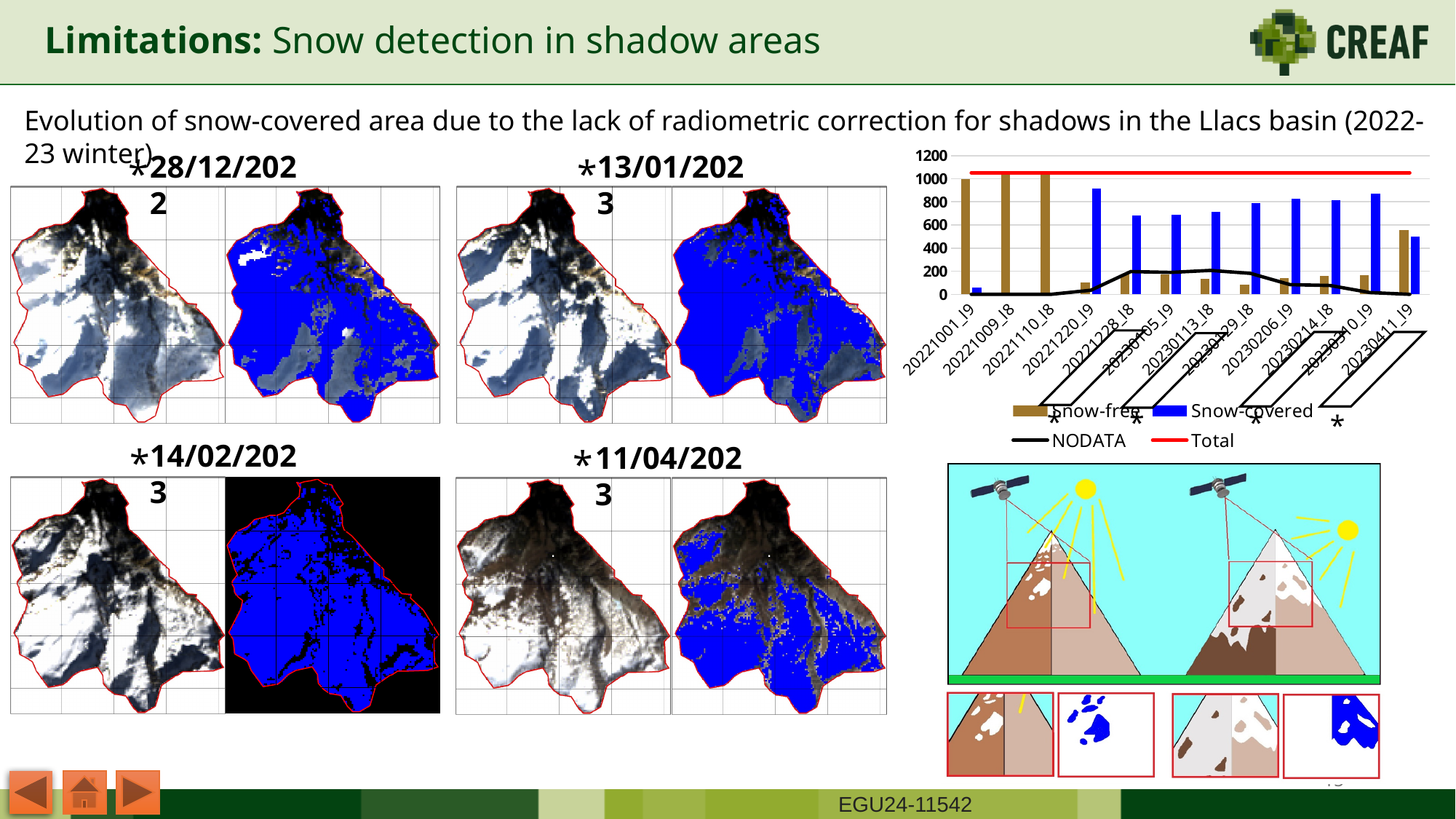
Is the Snow-covered value for 20230411_l9 greater or less than 600? less For 20221001_l9, which is larger: the Snow-free value or the Snow-covered value? Snow-free Which date has the lowest Snow-covered value in the chart? 20221009_l8 How many series does the legend of the chart list? 4 What kind of chart is shown on the right of the slide? combination bar and line chart Which series in the chart is drawn as a red line? Total Which series in the chart is drawn in blue? Snow-covered Is the Snow-covered value for 20221001_l9 greater or less than 200? less How many dates (categories) are shown on the x axis of the chart? 12 Is the Snow-covered value for 20221220_l9 greater or less than 800? greater Does the Snow-covered value rise or fall from 20221228_l8 to 20230310_l9? rise